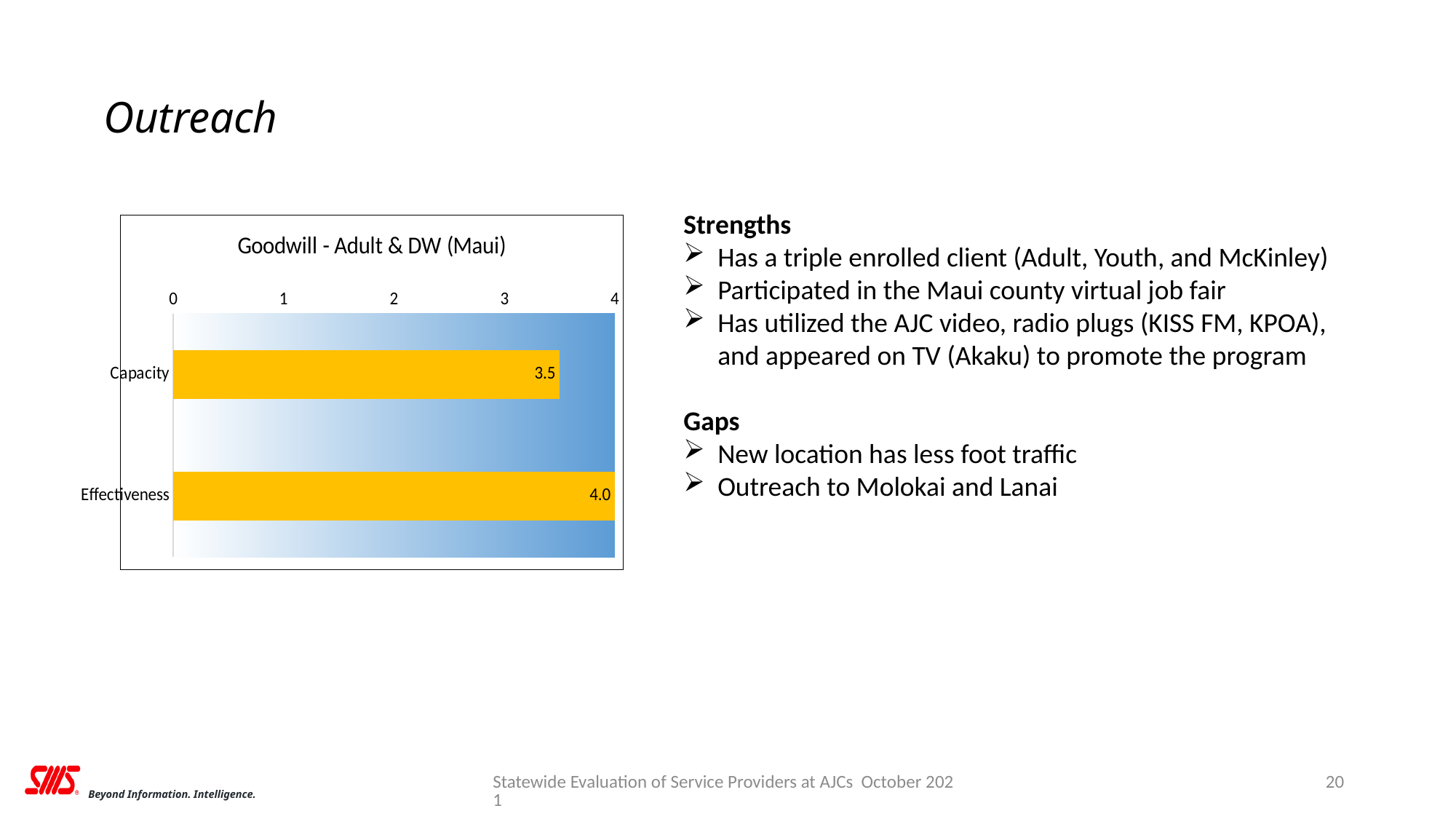
What is the maximum value shown on the chart's axis? 4 Which category has the lowest value? Capacity Is the value for Capacity greater or less than 3? greater What is the value for Effectiveness? 4.0 What is the difference between the Effectiveness and Capacity values? 0.5 What is the title of the chart? Goodwill - Adult & DW (Maui) Which is larger, the value for Capacity or the value for Effectiveness? Effectiveness Which category has the highest value? Effectiveness What kind of chart is shown on the slide? Bar chart How many categories are shown in the chart? 2 What is the value for Capacity? 3.5